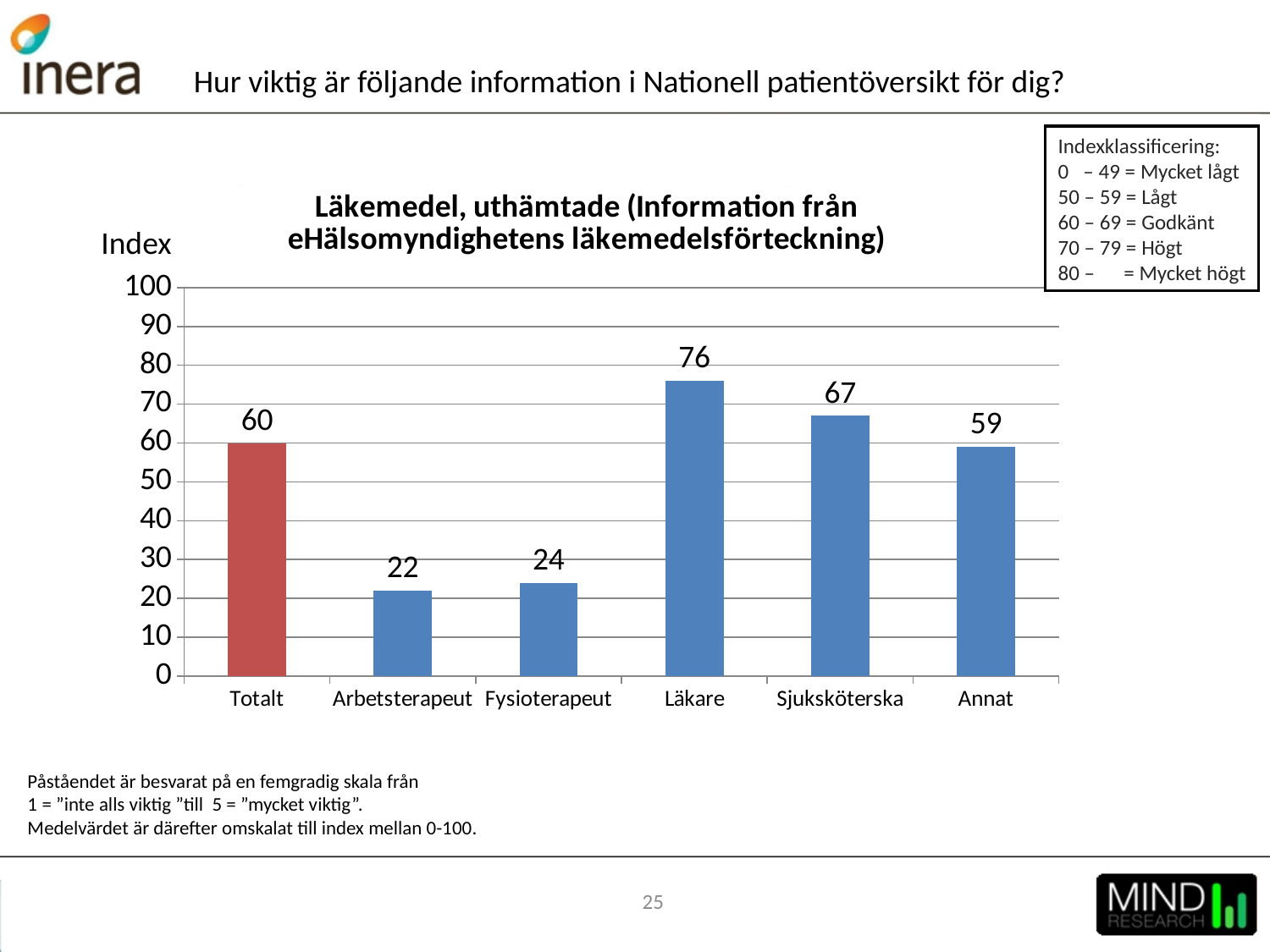
What is the index value for Totalt? 60 Is the value for Sjuksköterska greater or less than 60? greater What kind of chart is shown on the slide? bar chart Which bar is coloured red rather than blue? Totalt Which category has the lowest index value? Arbetsterapeut Which has a higher index value, Fysioterapeut or Annat? Annat Which category has the highest index value? Läkare What is the difference between the index values for Läkare and Sjuksköterska? 9 What is the title of the chart? Läkemedel, uthämtade (Information från eHälsomyndighetens läkemedelsförteckning) How many categories are shown on the x axis? 6 What is the index value for Läkare? 76 What is the index value for Arbetsterapeut? 22